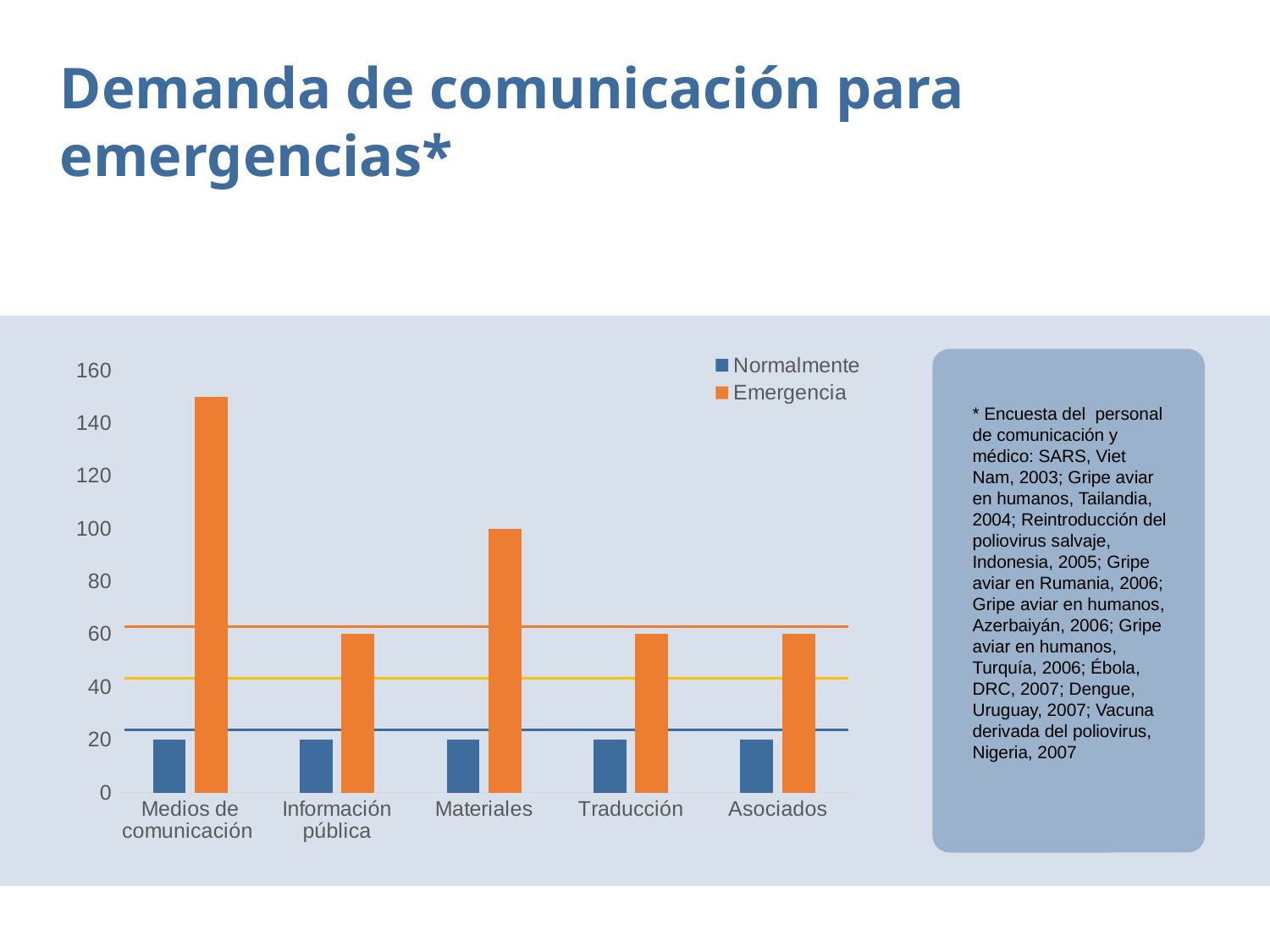
Is the Emergencia value for Información pública greater or less than 80? less What are the two series named in the legend? Normalmente and Emergencia What kind of chart is shown on the slide? bar chart How many categories are shown on the x axis? 5 Is the Emergencia value for Materiales greater or less than 80? greater Is the Emergencia value for Medios de comunicación greater or less than 140? greater How many series does the legend list? 2 What colour are the Emergencia bars? orange Which category has the highest Emergencia value? Medios de comunicación For Asociados, which series has the larger value, Normalmente or Emergencia? Emergencia Which is larger, the Emergencia value for Materiales or the Emergencia value for Traducción? Materiales